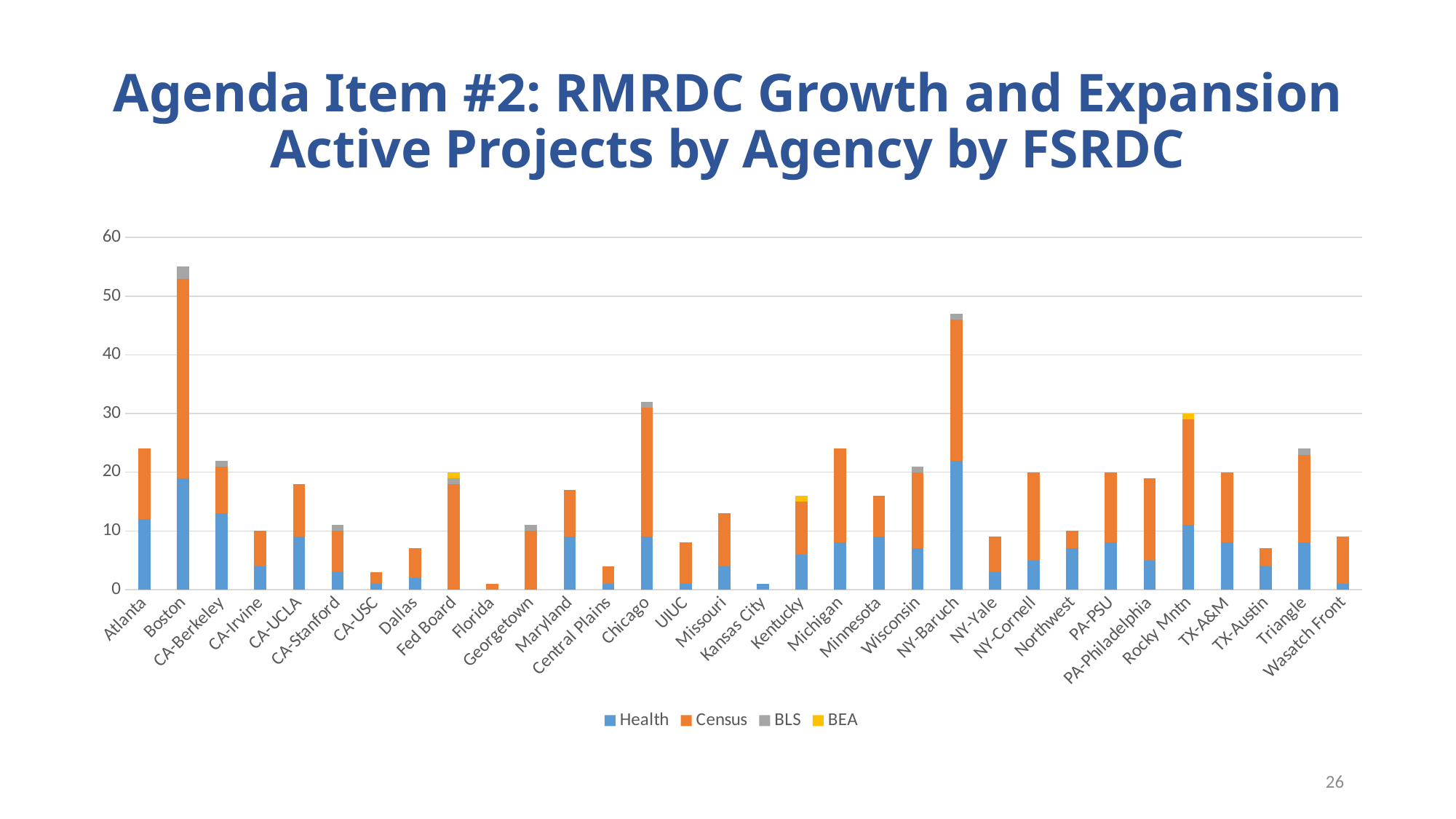
Is the total for Boston greater or less than 50? greater How many series does the legend list? 4 Is the total for CA-USC greater or less than 10? less Which has a larger total of active projects, Boston or NY-Baruch? Boston How many FSRDC locations are shown along the x axis? 32 Is the total for Chicago greater or less than 30? greater Which has a larger total of active projects, Chicago or Michigan? Chicago Which series in the legend is shown in yellow? BEA Which FSRDC has the highest total number of active projects? Boston What kind of chart is shown on the slide? Stacked bar chart